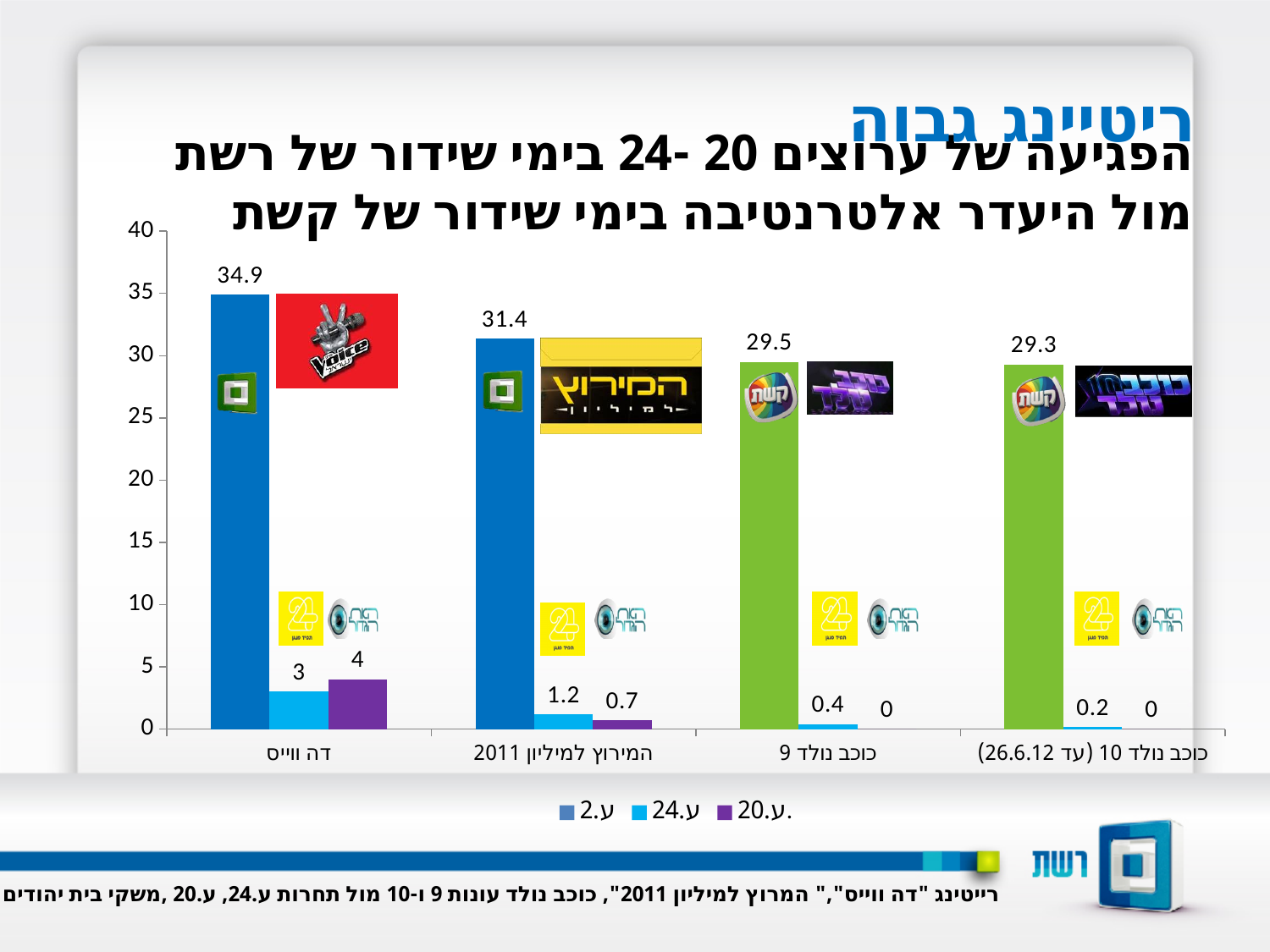
What is the value of the tallest bar for כוכב נולד 9? 29.5 How many series does the chart legend list? 3 How many categories are shown on the x axis of the chart? 4 What is the difference between the tallest bars of דה ווייס and המירוץ למיליון 2011? 3.5 What is the value of the tallest bar for דה ווייס? 34.9 Which is larger for המירוץ למיליון 2011: the ע.24 value or the ע.20 value? ע.24 Which category has the highest value for its tallest bar? דה ווייס What type of chart is shown on the slide? bar chart What is the value of the ע.20 series for דה ווייס? 4 What is the value of the ע.24 series for כוכב נולד 10 (עד 26.6.12)? 0.2 What is the value of the tallest bar for המירוץ למיליון 2011? 31.4 Is the tallest bar for כוכב נולד 10 (עד 26.6.12) greater or less than 30? less